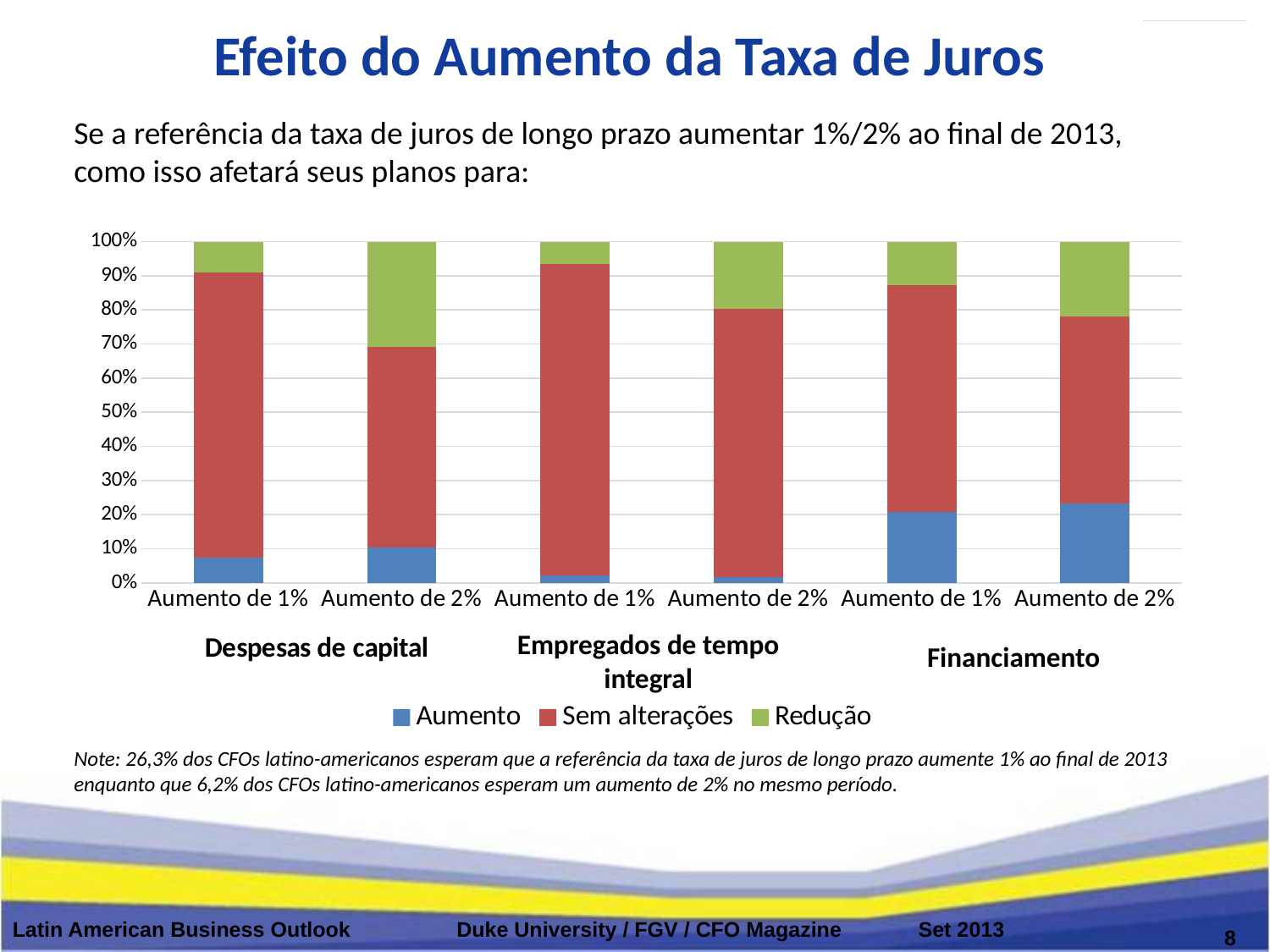
How many series does the legend list? 3 Is the Aumento share for Financiamento under Aumento de 2% greater or less than 20%? greater Within Financiamento, does the Redução share rise or fall from Aumento de 1% to Aumento de 2%? rises Is the Aumento share for Despesas de capital under Aumento de 1% greater or less than 10%? less Which has the larger Aumento share: Financiamento under Aumento de 2% or Despesas de capital under Aumento de 1%? Financiamento under Aumento de 2% Which bar has the largest Redução share? Despesas de capital, Aumento de 2% Is the Redução share for Empregados de tempo integral under Aumento de 1% greater or less than 10%? less What kind of chart is shown on the slide? Stacked bar chart Which series is shown in green? Redução How many bars are plotted in the chart? 6 What are the three series named in the legend? Aumento, Sem alterações, Redução